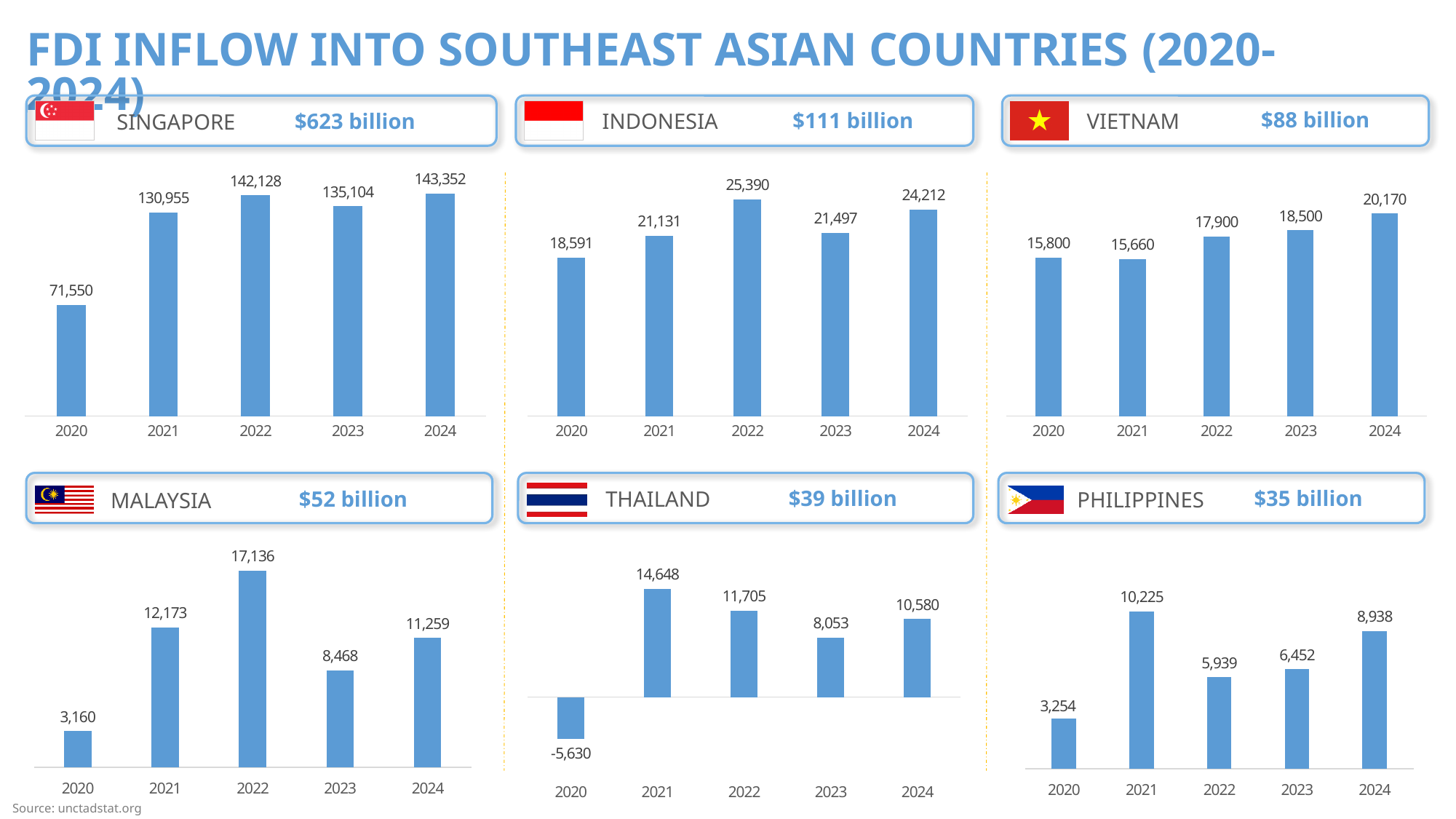
In the Singapore chart, what is the value for 2024? 143,352 In the Thailand chart, what is the value for 2020? -5,630 In the Singapore chart, is the value for 2022 larger or smaller than the value for 2023? larger What total FDI inflow is shown in the header for Malaysia? $52 billion In the Philippines chart, what is the difference between the 2021 and 2020 values? 6,971 What kind of chart is used for Thailand? bar chart In the Indonesia chart, what is the difference between the 2022 and 2021 values? 4,259 In the Vietnam chart, do the values generally rise or fall from 2021 to 2024? rise In the Vietnam chart, what is the value for 2021? 15,660 In the Indonesia chart, which year has the highest value? 2022 In the Malaysia chart, which year has the lowest value? 2020 How many years are shown in the Vietnam chart? 5